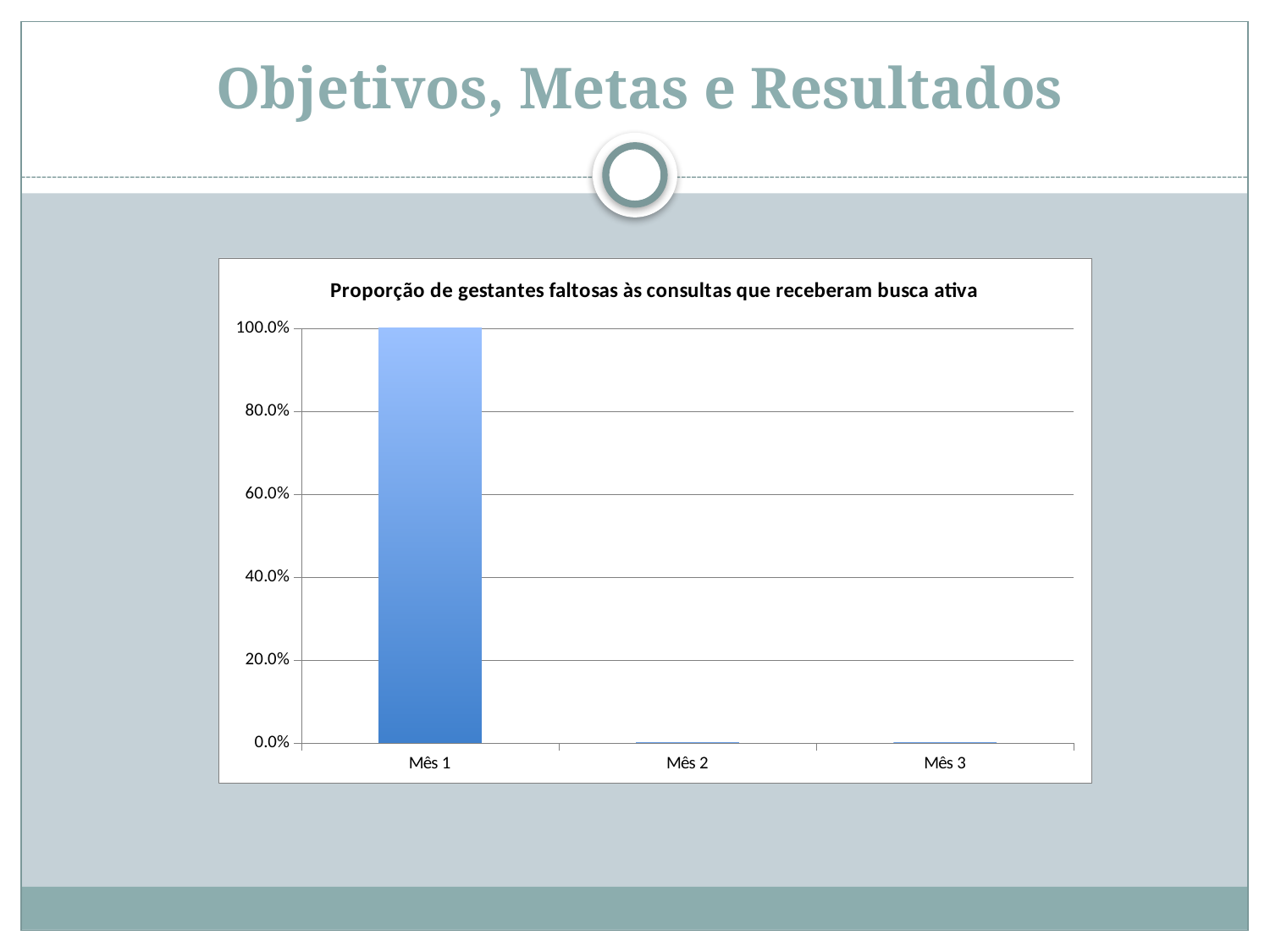
Is the value for Mês 3 greater or less than 20.0%? less What is the title of the chart? Proporção de gestantes faltosas às consultas que receberam busca ativa Do the values rise or fall from Mês 1 to Mês 3? fall How many categories are shown on the x axis of the chart? 3 Which is larger, the value for Mês 1 or the value for Mês 3? Mês 1 Which month has the highest value? Mês 1 What kind of chart is shown on the slide? bar chart Is the value for Mês 1 greater or less than 80.0%? greater What is the value for Mês 1? 100.0% What is the highest value shown on the y axis of the chart? 100.0% Is the value for Mês 2 greater or less than 20.0%? less Which is larger, the value for Mês 1 or the value for Mês 2? Mês 1